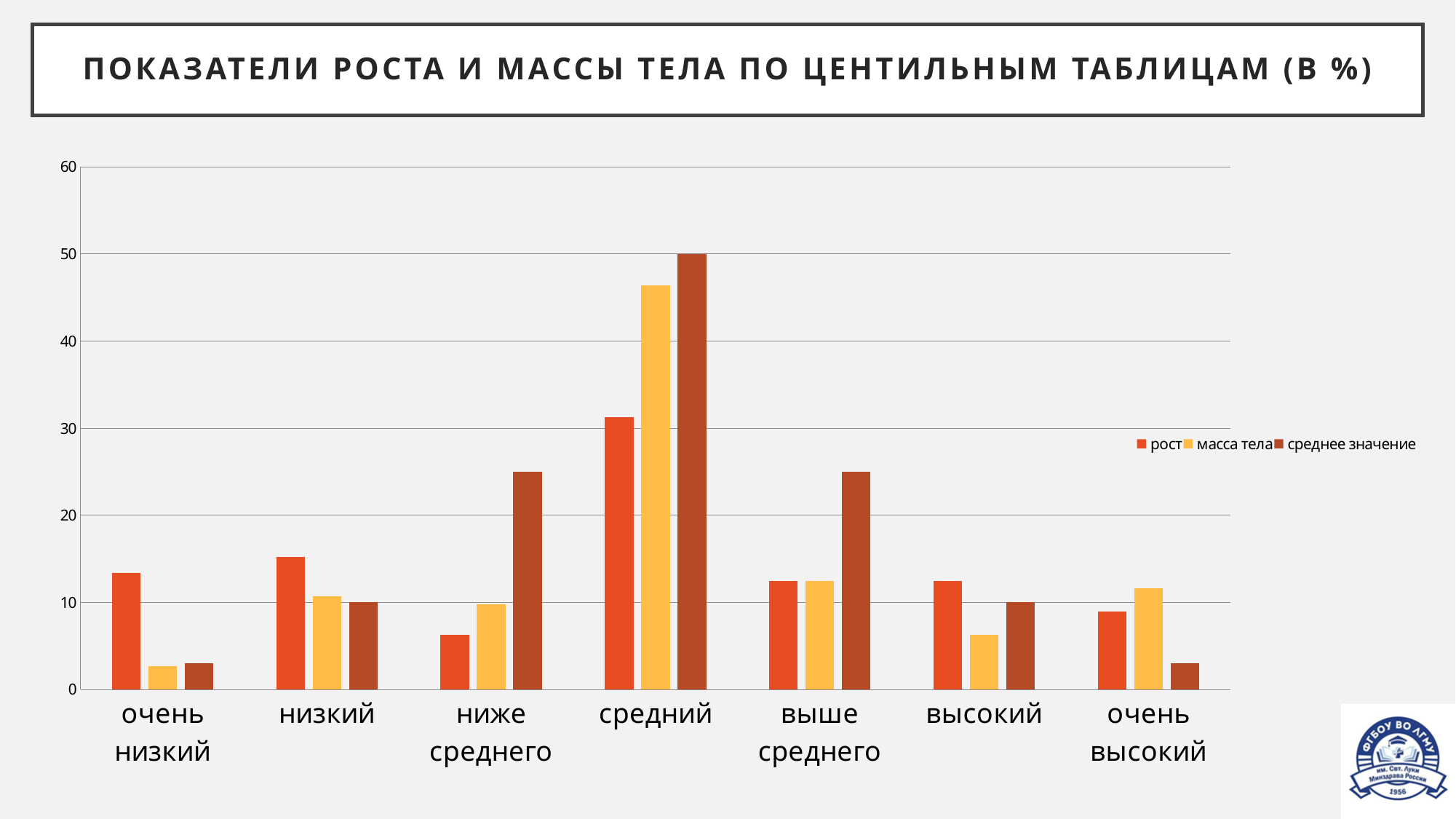
What is the value of "среднее значение" for the category "высокий"? 10 What is the title of the chart? ПОКАЗАТЕЛИ РОСТА И МАССЫ ТЕЛА ПО ЦЕНТИЛЬНЫМ ТАБЛИЦАМ (В %) What kind of chart is shown on the slide? bar chart What is the value of "среднее значение" for the category "средний"? 50 Is the value for "масса тела" in the category "средний" greater or less than 50? less Which category has the lowest value for "масса тела"? очень низкий For the category "очень низкий", which is larger: "рост" or "масса тела"? рост Is the value for "рост" in the category "средний" greater or less than 30? greater What is the value of "среднее значение" for the category "низкий"? 10 Which category has the highest value for "рост"? средний How many categories are shown on the x axis? 7 How many series does the legend list? 3